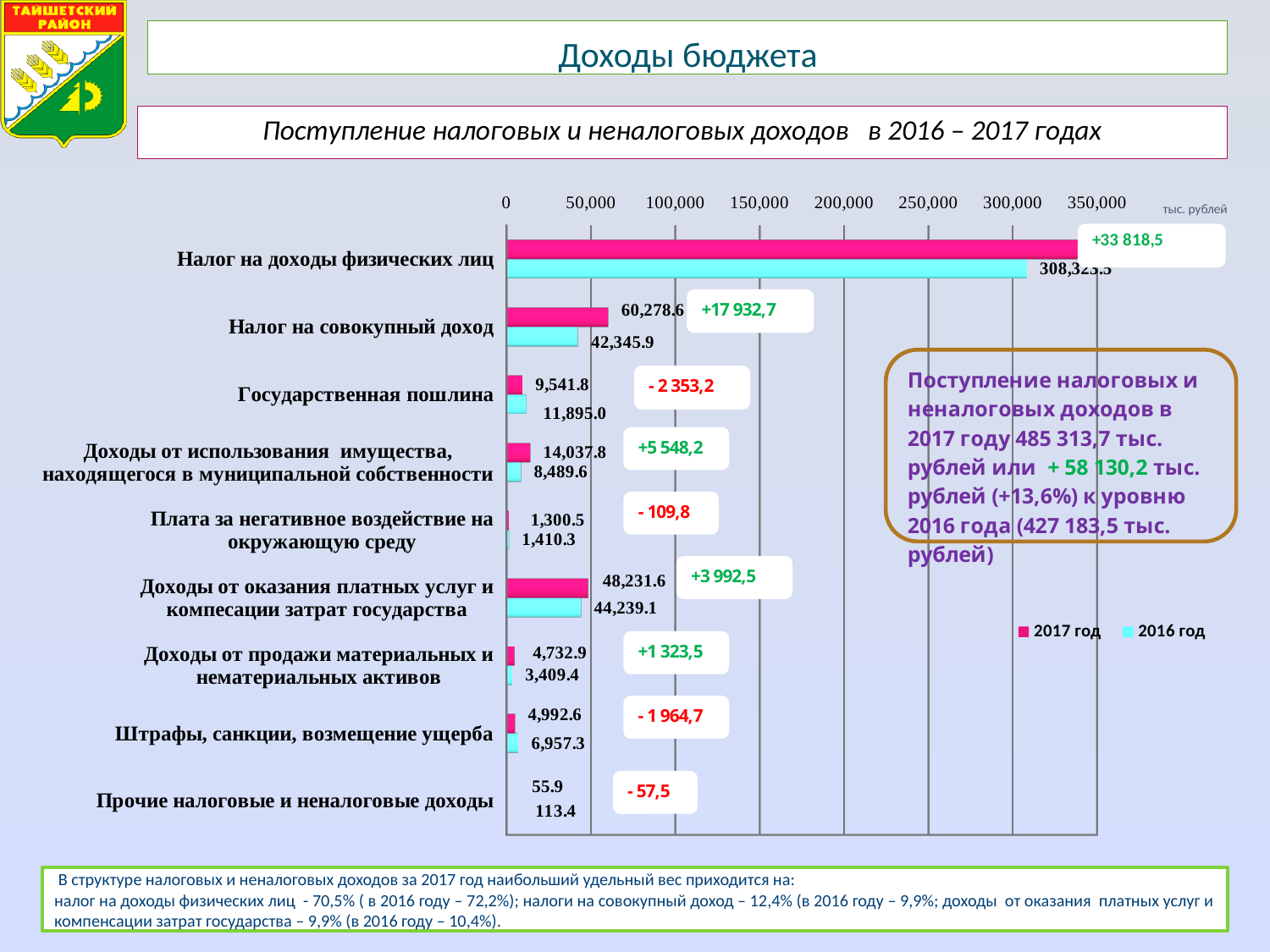
Which category has the highest 2017 value? Налог на доходы физических лиц What is the difference between the 2017 and 2016 values for Налог на совокупный доход? 17,932.7 Which is larger for Плата за негативное воздействие на окружающую среду: the 2017 value or the 2016 value? 2016 value What is the 2017 value for Налог на совокупный доход? 60,278.6 How many categories are plotted on the chart? 9 How many series does the chart legend list? 2 What is the 2017 value for Доходы от оказания платных услуг и компесации затрат государства? 48,231.6 Is the 2017 value for Налог на доходы физических лиц greater or less than 300,000? greater What type of chart is shown on the slide? bar chart What is the 2016 value for Государственная пошлина? 11,895.0 What is the 2016 value for Штрафы, санкции, возмещение ущерба? 6,957.3 Which category has the lowest 2016 value? Прочие налоговые и неналоговые доходы